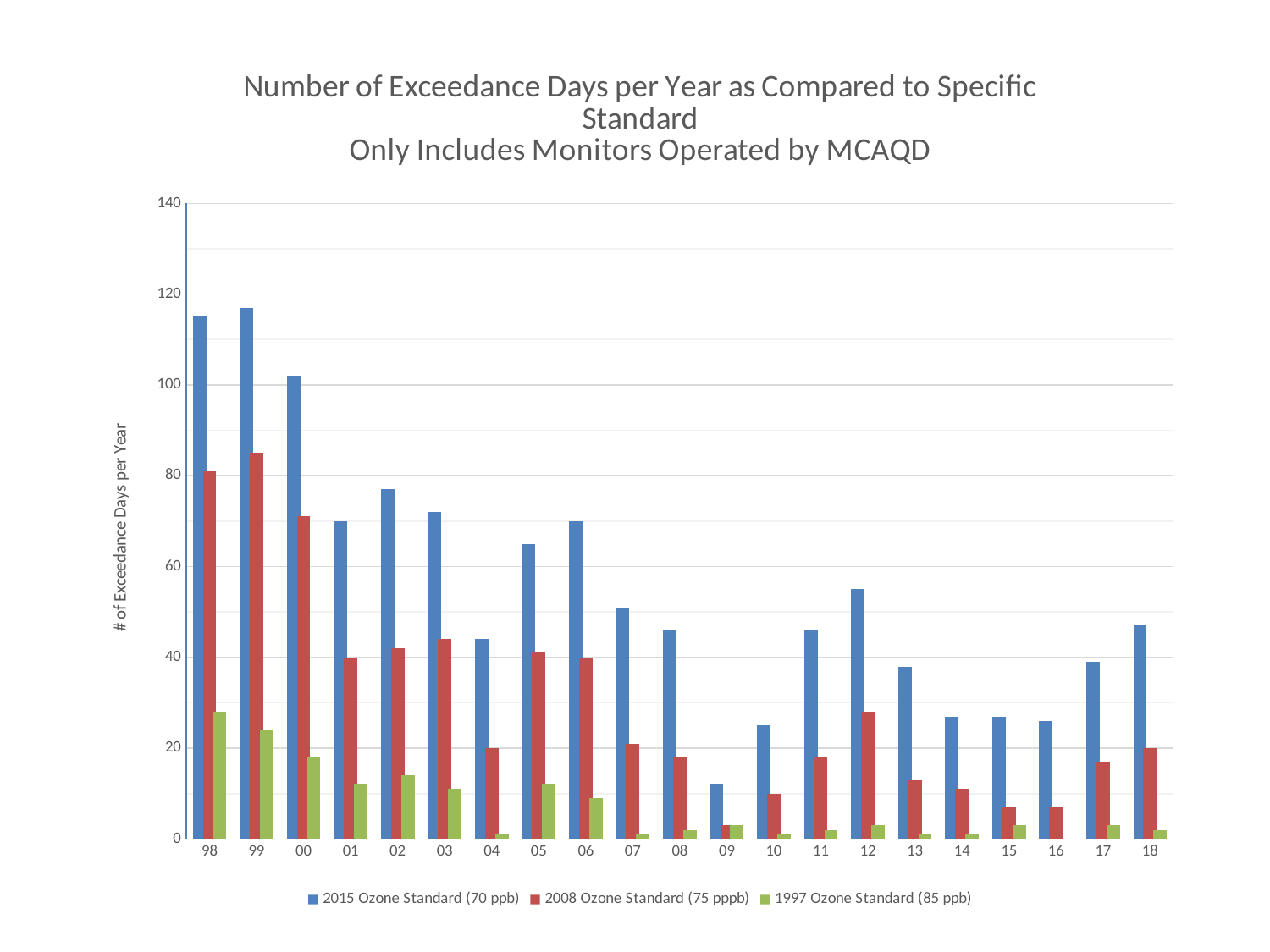
Is the value for the 2015 Ozone Standard (70 ppb) in 09 greater or less than 20? less How many series does the legend list? 3 Which year has the highest value for the 1997 Ozone Standard (85 ppb) series? 98 Does the 2015 Ozone Standard (70 ppb) series generally rise or fall from 98 to 09? fall What is the title of the vertical axis? # of Exceedance Days per Year Is the value for the 2008 Ozone Standard (75 pppb) in 10 greater or less than 20? less What kind of chart is shown on the slide? bar chart How many years are shown along the x axis? 21 Which year has the lowest value for the 2015 Ozone Standard (70 ppb) series? 09 Which is larger for the 2015 Ozone Standard (70 ppb) series: the value in 11 or the value in 12? 12 Which year has the lowest value for the 2008 Ozone Standard (75 pppb) series? 09 Is the value for the 2015 Ozone Standard (70 ppb) in 98 greater or less than 100? greater